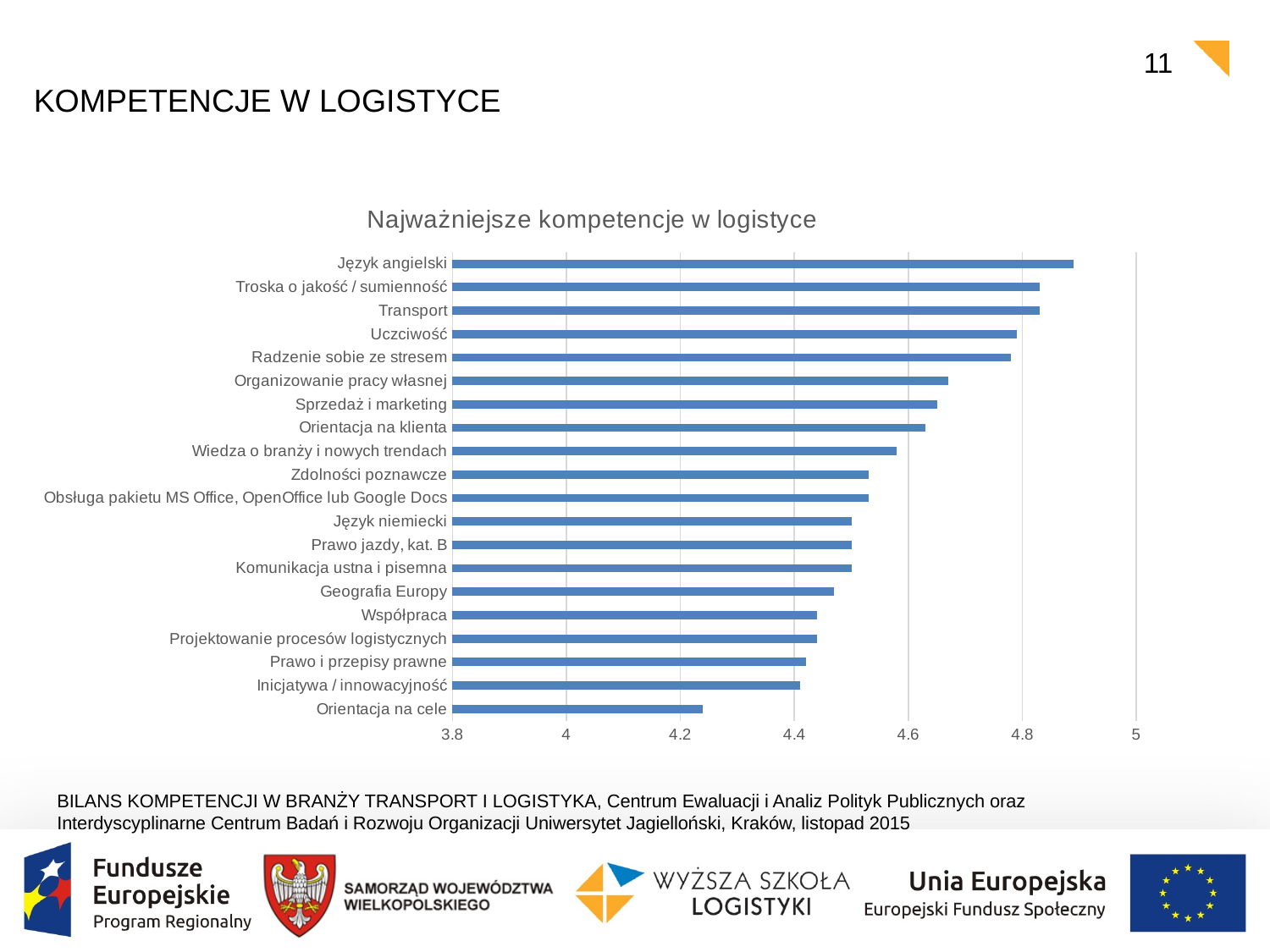
How many competencies (categories) are plotted in the chart? 20 Is the value for Uczciwość greater or less than 4.6? greater Is the value for Organizowanie pracy własnej greater or less than 4.6? greater Which has a larger value: Uczciwość or Geografia Europy? Uczciwość Is the value for Język angielski greater or less than 4.8? greater What is the title of the chart? Najważniejsze kompetencje w logistyce Which has a larger value: Współpraca or Transport? Transport What kind of chart is shown on the slide? Bar chart Which competency has the lowest value in the chart? Orientacja na cele Which competency has the highest value in the chart? Język angielski